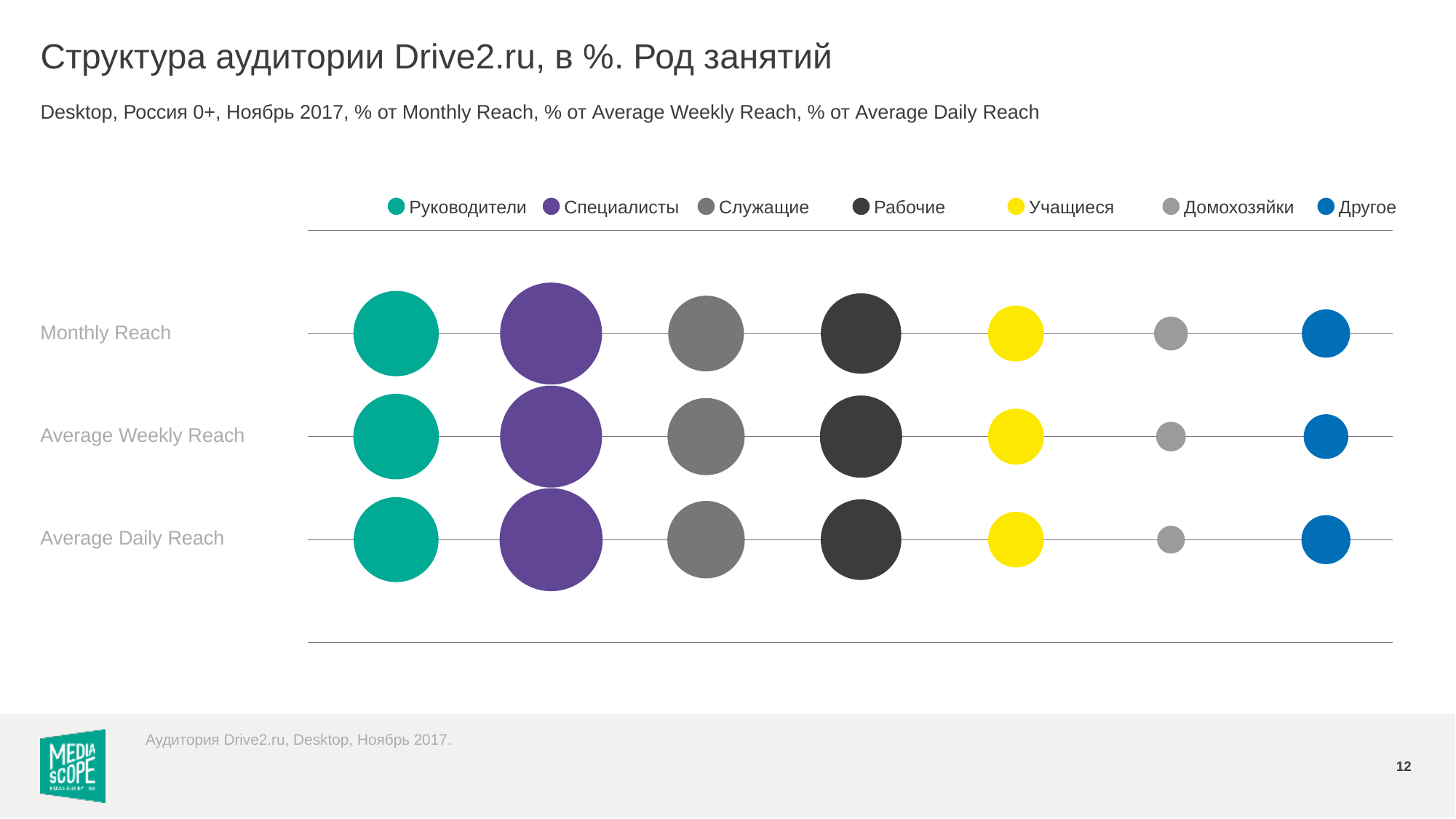
Which occupation group has the largest bubble in the Monthly Reach row? Специалисты How many reach categories (rows) are plotted on the chart? 3 Which occupation group has the largest bubble in the Average Daily Reach row? Специалисты Which occupation group has the smallest bubble in the Average Weekly Reach row? Домохозяйки Which legend entry is shown in yellow? Учащиеся Which occupation group has the smallest bubble in the Monthly Reach row? Домохозяйки What kind of chart is shown on the slide? bubble chart In the Average Weekly Reach row, which bubble is larger: Домохозяйки or Рабочие? Рабочие What is the title of the chart on the slide? Структура аудитории Drive2.ru, в %. Род занятий In the Monthly Reach row, which bubble is larger: Руководители or Учащиеся? Руководители In the Average Daily Reach row, which bubble is larger: Специалисты or Другое? Специалисты How many series does the legend list? 7